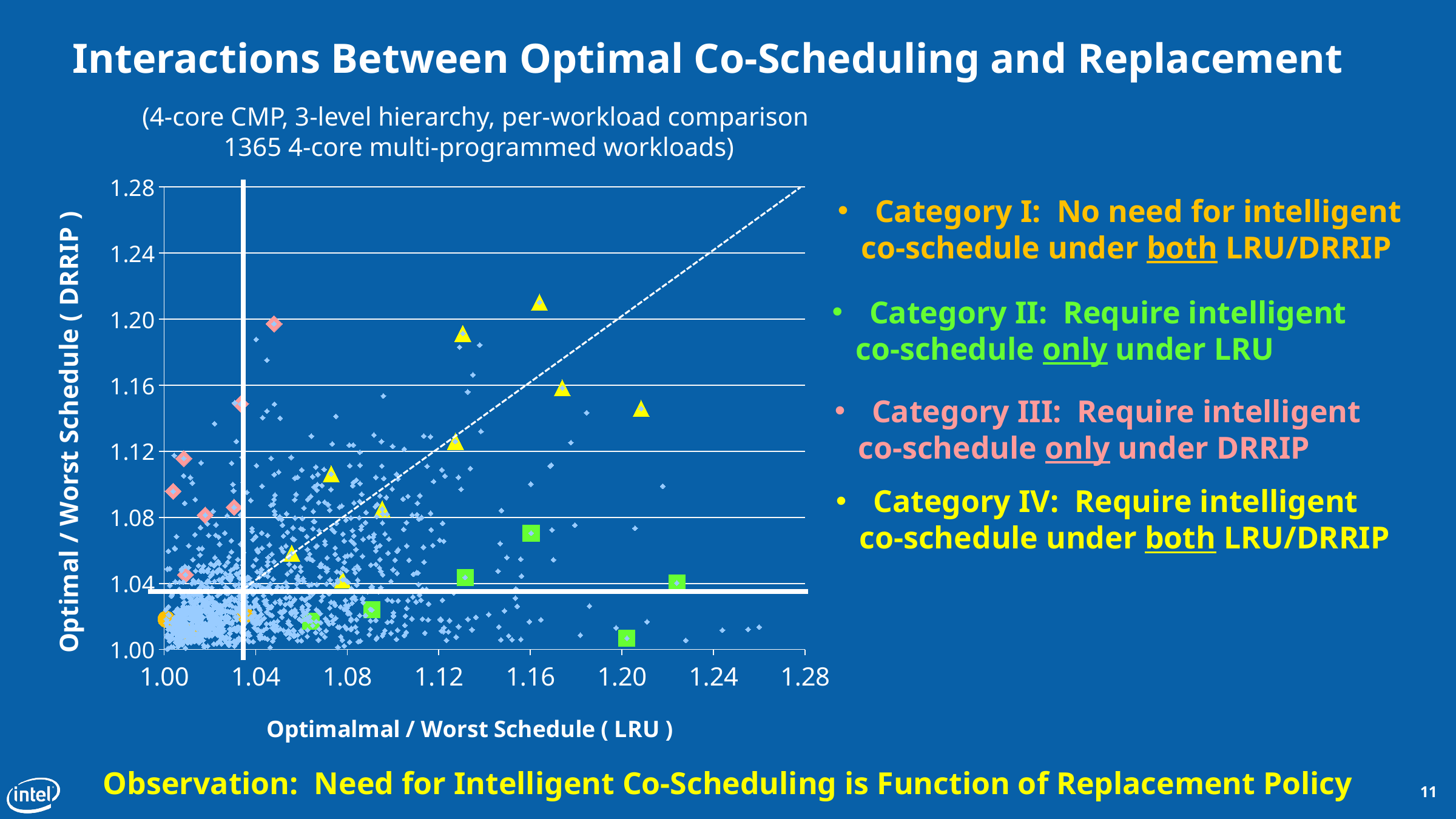
What is the label of the y axis of the chart? Optimal / Worst Schedule ( DRRIP ) Is the LRU value of the rightmost green square greater or less than 1.20? greater Is the DRRIP value of the lowest green square (near x = 1.20) greater or less than 1.04? less What is the label of the x axis of the chart? Optimalmal / Worst Schedule ( LRU ) According to the subtitle above the chart, how many 4-core multi-programmed workloads are plotted? 1365 What is the lowest value shown on the x axis of the chart? 1.00 Which category's markers are drawn as green squares in the chart? Category II What kind of chart is shown on the slide? scatter chart Is the LRU value of the pink diamond near y = 1.12 greater or less than 1.04? less What is the highest value shown on the y axis of the chart? 1.28